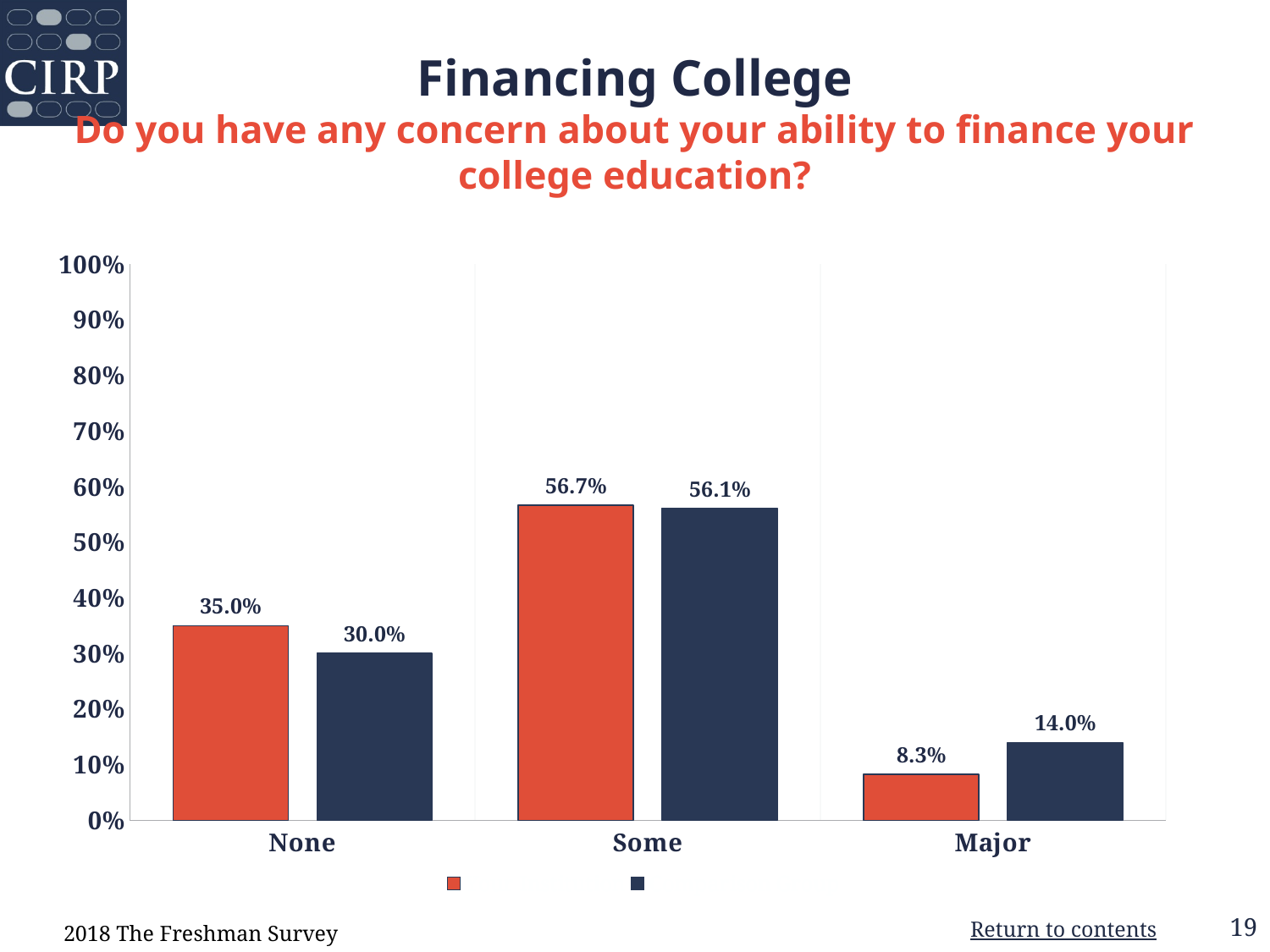
Which category has the highest value for the orange bars? Some How many categories are shown on the x axis? 3 What is the value of the dark blue bar for the 'None' category? 30.0% What kind of chart is shown on the slide? bar chart In the 'Major' category, which bar is larger, the orange bar or the dark blue bar? dark blue bar What is the value of the orange bar for the 'None' category? 35.0% What is the difference between the dark blue and orange bars in the 'Major' category? 5.7% Which category has the lowest value for the dark blue bars? Major What is the value of the orange bar for the 'Some' category? 56.7% What is the difference between the orange and dark blue bars in the 'None' category? 5.0% What is the title of the chart's question shown on the slide? Do you have any concern about your ability to finance your college education? What is the value of the dark blue bar for the 'Major' category? 14.0%